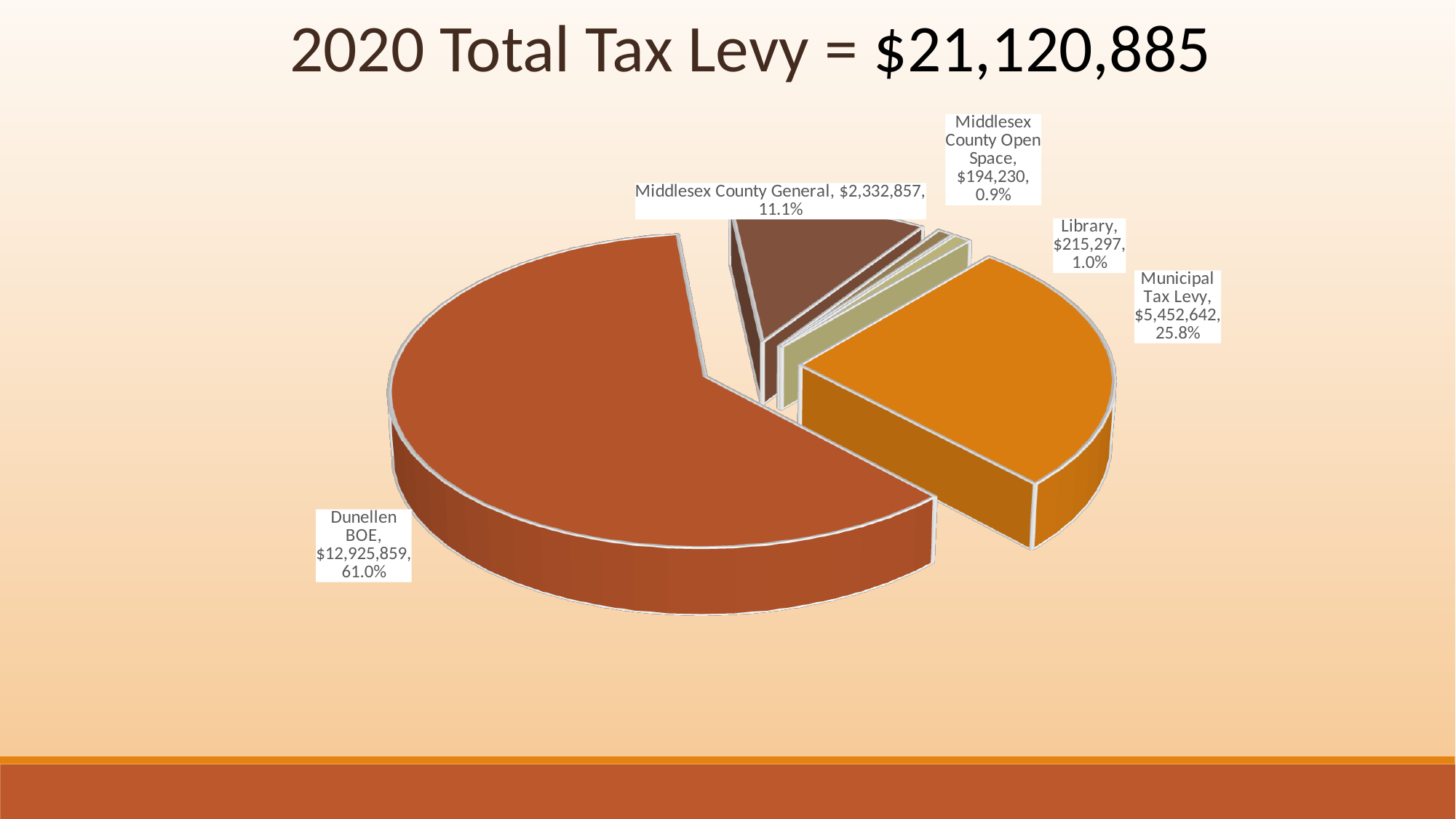
What is the difference in dollars between Dunellen BOE and the Municipal Tax Levy? $7,473,217 How many slices does the pie chart have? 5 Which category has the smallest slice of the pie? Middlesex County Open Space What is the dollar amount for Middlesex County General? $2,332,857 What is the difference in dollars between the Library and Middlesex County Open Space? $21,067 What total tax levy is stated in the chart title? $21,120,885 What is the dollar amount for the Library? $215,297 Which category has the largest slice of the pie? Dunellen BOE What is the dollar amount for Dunellen BOE? $12,925,859 What kind of chart is shown on the slide? Pie chart Which is larger, the Library amount or the Middlesex County Open Space amount? Library What percentage of the pie does the Municipal Tax Levy slice represent? 25.8%